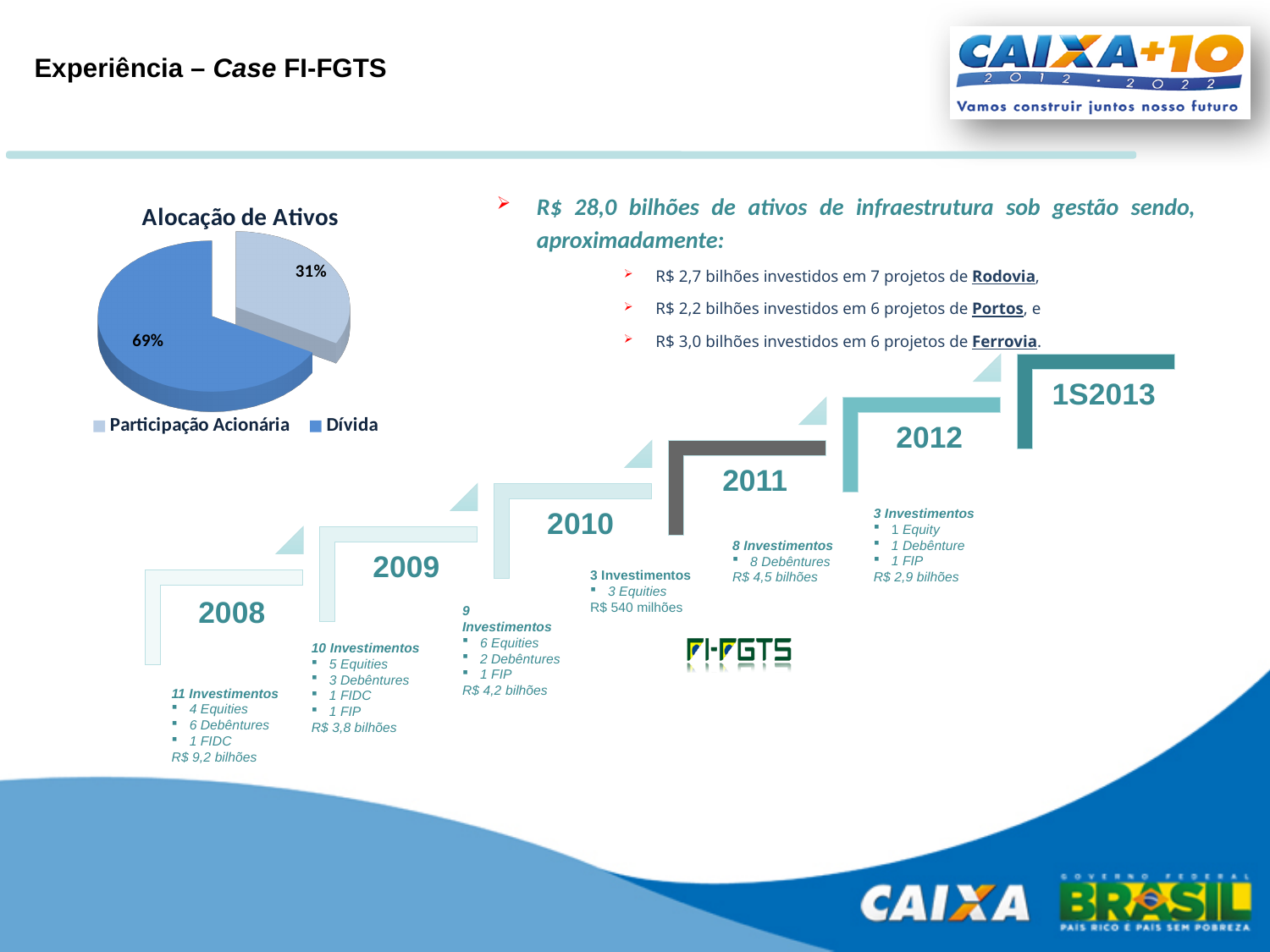
What kind of chart is shown under the title "Alocação de Ativos"? Pie chart How many entries does the legend of the "Alocação de Ativos" pie chart list? 2 Which slice of the "Alocação de Ativos" pie chart is the largest? Dívida How many slices does the "Alocação de Ativos" pie chart have? 2 In the "Alocação de Ativos" pie chart, which slice is shown in the lighter blue colour? Participação Acionária In the "Alocação de Ativos" pie chart, what share is labelled for Participação Acionária? 31% What is the title of the pie chart on the slide? Alocação de Ativos Which slice of the "Alocação de Ativos" pie chart is the smallest? Participação Acionária In the "Alocação de Ativos" pie chart, which is larger: Dívida or Participação Acionária? Dívida In the "Alocação de Ativos" pie chart, by how many percentage points does Dívida exceed Participação Acionária? 38 percentage points In the "Alocação de Ativos" pie chart, what is the combined share of Dívida and Participação Acionária? 100% In the "Alocação de Ativos" pie chart, what share is labelled for Dívida? 69%